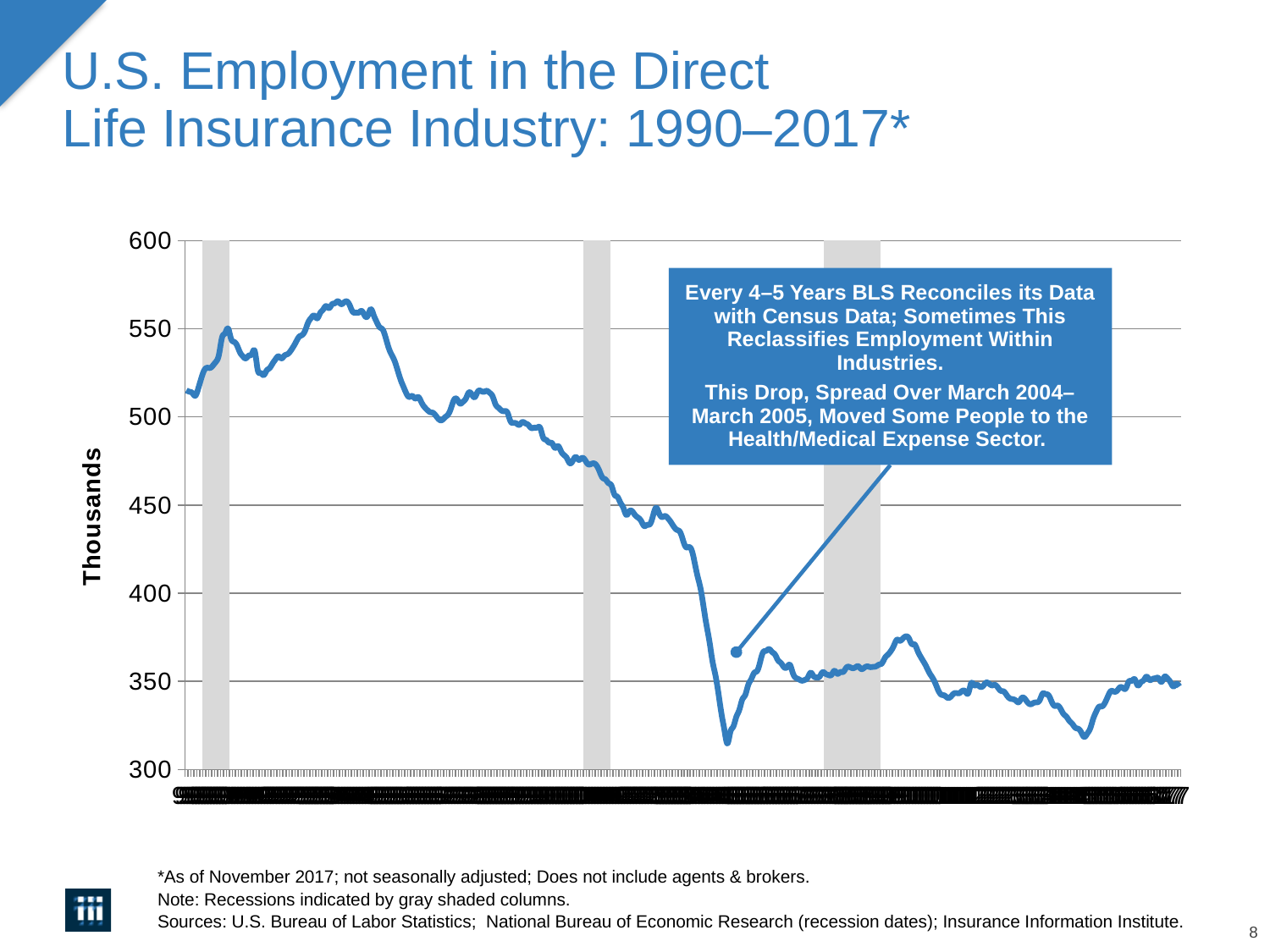
How many gray shaded recession columns appear on the chart? 3 What is the lowest value shown on the vertical axis? 300 What is the title of the chart? U.S. Employment in the Direct Life Insurance Industry: 1990–2017* Is the value at the end of the series (right end of the line) greater or less than 400? less What is the highest value shown on the vertical axis? 600 Is the lowest point of the line greater or less than 350? less Overall, do the values rise or fall from the left to the right of the chart? fall What kind of chart is shown on the slide? line chart Is the highest point of the line greater or less than 550? greater